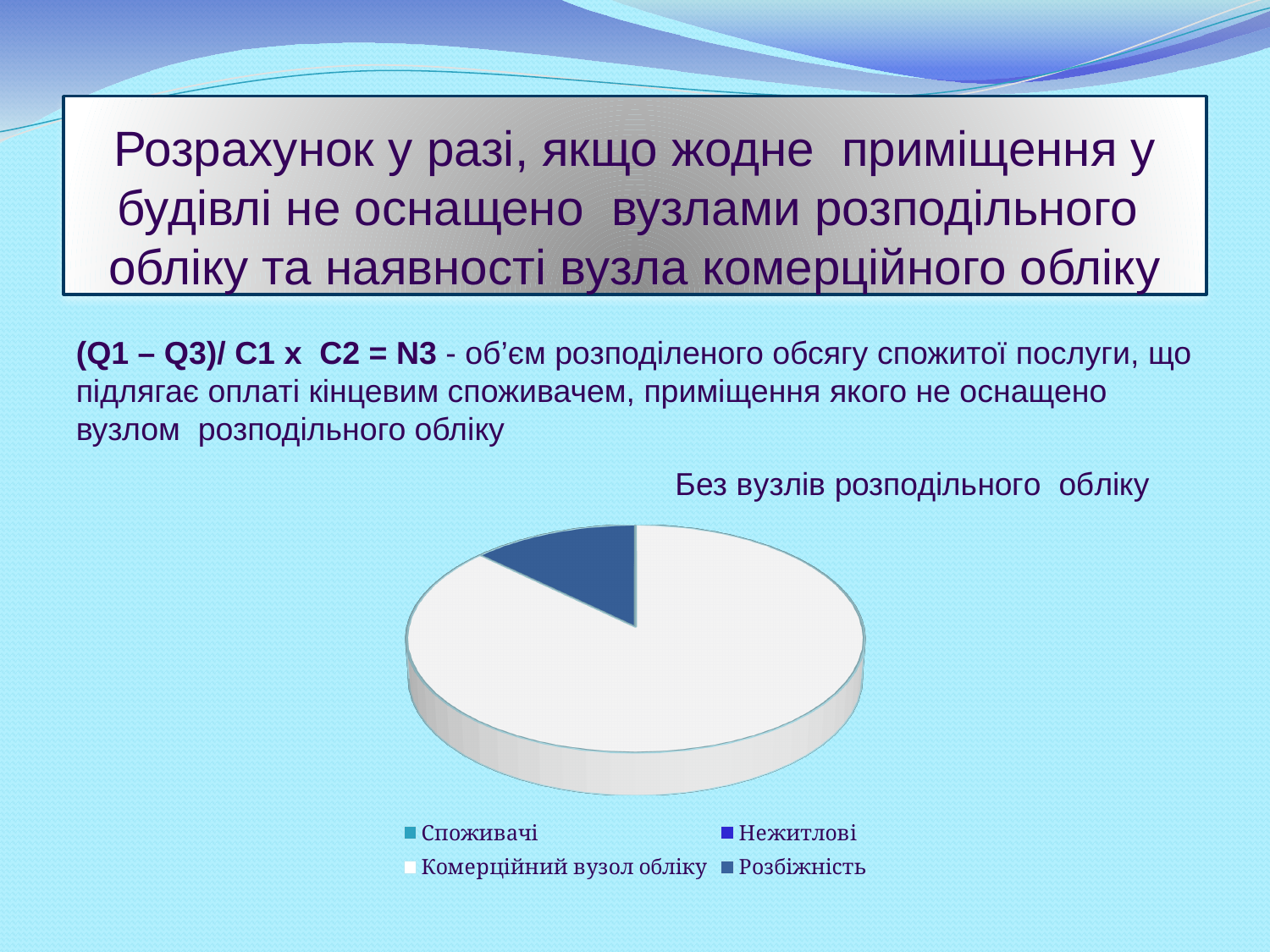
What kind of chart is shown on the slide? Pie chart How many entries does the legend of the pie chart list? 4 Which legend entry is listed first in the pie chart's legend? Споживачі Which is larger in the pie chart: the slice for Комерційний вузол обліку or the slice for Розбіжність? Комерційний вузол обліку Which category has the largest slice in the pie chart? Комерційний вузол обліку What is the title of the pie chart? Без вузлів розподільного обліку What colour is the largest slice of the pie chart? White